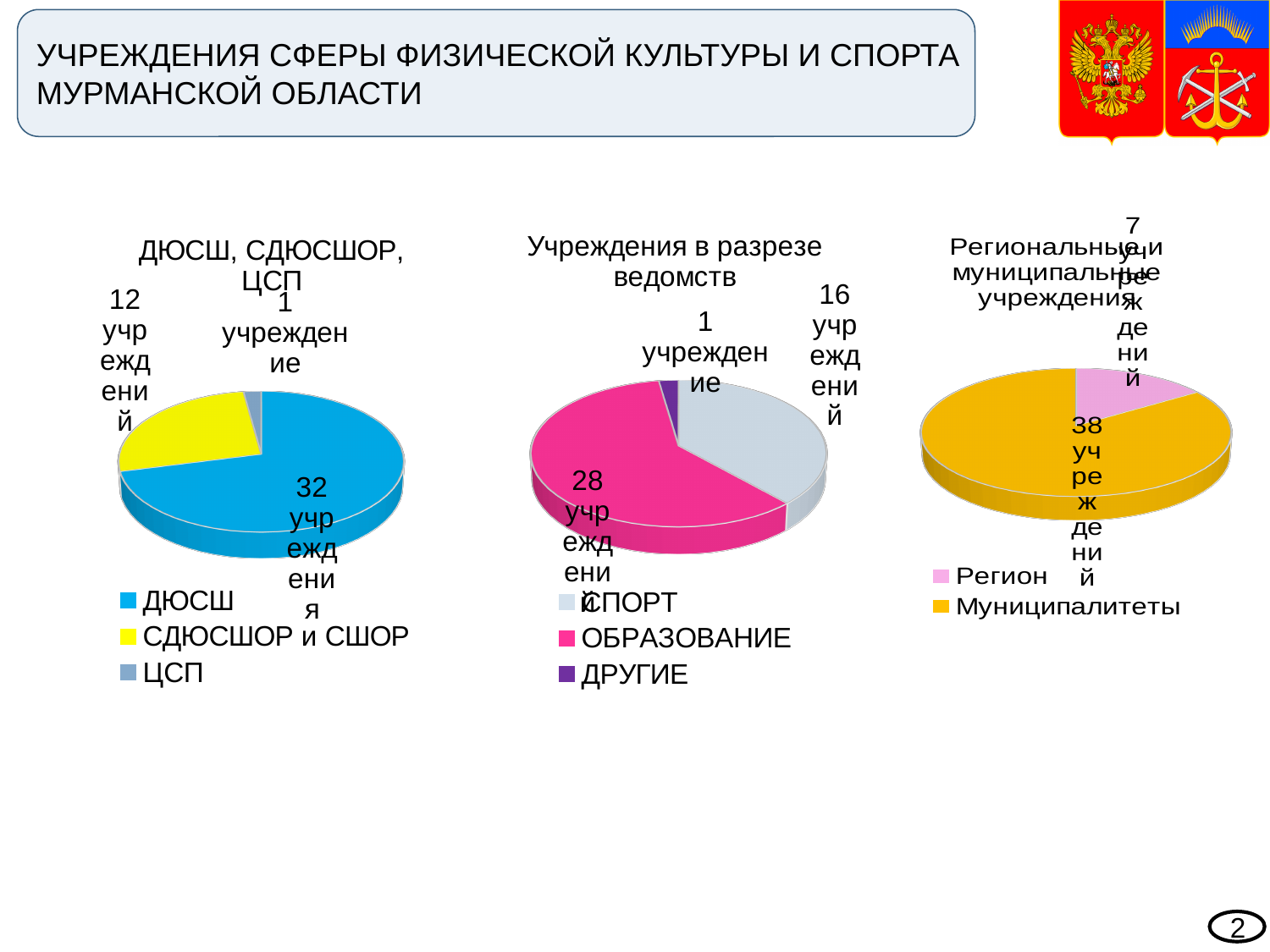
On the chart titled "Региональные и муниципальные учреждения", what is the value for Муниципалитеты? 38 учреждений On the chart titled "Учреждения в разрезе ведомств", what is the value for ОБРАЗОВАНИЕ? 28 учреждений On the chart titled "ДЮСШ, СДЮСШОР, ЦСП", what is the value for ЦСП? 1 учреждение On the chart titled "ДЮСШ, СДЮСШОР, ЦСП", what is the value for ДЮСШ? 32 учреждения On the chart titled "ДЮСШ, СДЮСШОР, ЦСП", which category has the largest slice? ДЮСШ On the chart titled "ДЮСШ, СДЮСШОР, ЦСП", what is the difference between the ДЮСШ value and the СДЮСШОР и СШОР value? 20 On the chart titled "Региональные и муниципальные учреждения", what is the total of the two slices? 45 On the chart titled "Региональные и муниципальные учреждения", which is larger, Регион or Муниципалитеты? Муниципалитеты On the chart titled "Учреждения в разрезе ведомств", what is the value for СПОРТ? 16 учреждений On the chart titled "Учреждения в разрезе ведомств", how many categories does the legend list? 3 On the chart titled "Учреждения в разрезе ведомств", which category has the smallest slice? ДРУГИЕ What type of chart is used for the three charts on the slide? Pie chart